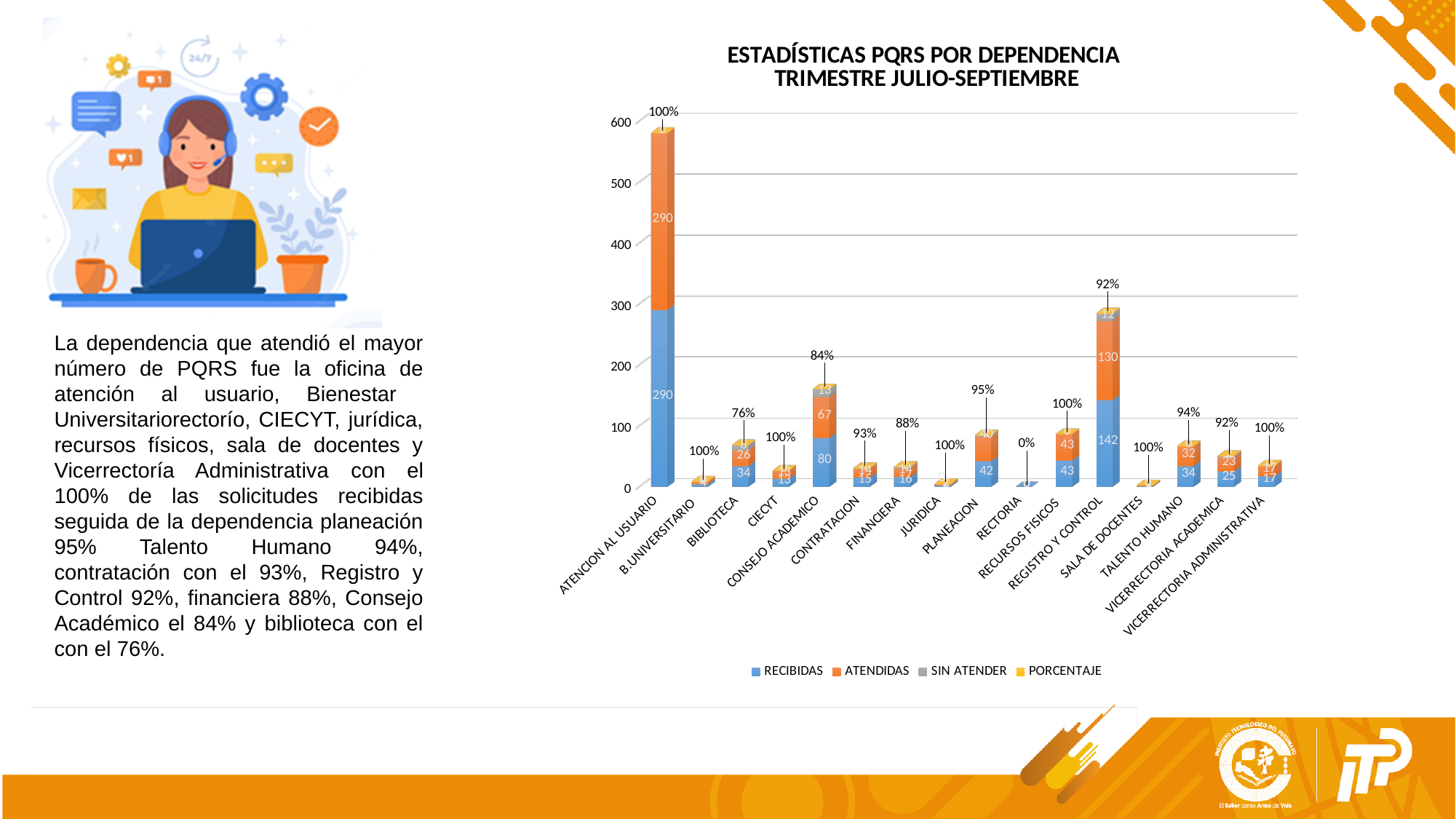
Which dependencia has the tallest stacked bar? ATENCION AL USUARIO What is the RECIBIDAS value for ATENCION AL USUARIO? 290 Which dependencia shows a percentage of 0%? RECTORIA How many series does the legend list? 4 Which has a higher RECIBIDAS value, CONSEJO ACADEMICO or PLANEACION? CONSEJO ACADEMICO What is the ATENDIDAS value for CONSEJO ACADEMICO? 67 How many dependencias are shown on the x axis? 16 What is the difference between RECIBIDAS and ATENDIDAS for REGISTRO Y CONTROL? 12 What type of chart is shown on the slide? Stacked bar chart What PORCENTAJE is shown above the BIBLIOTECA bar? 76% What is the RECIBIDAS value for REGISTRO Y CONTROL? 142 Is the total height of the ATENCION AL USUARIO bar greater or less than 500? greater